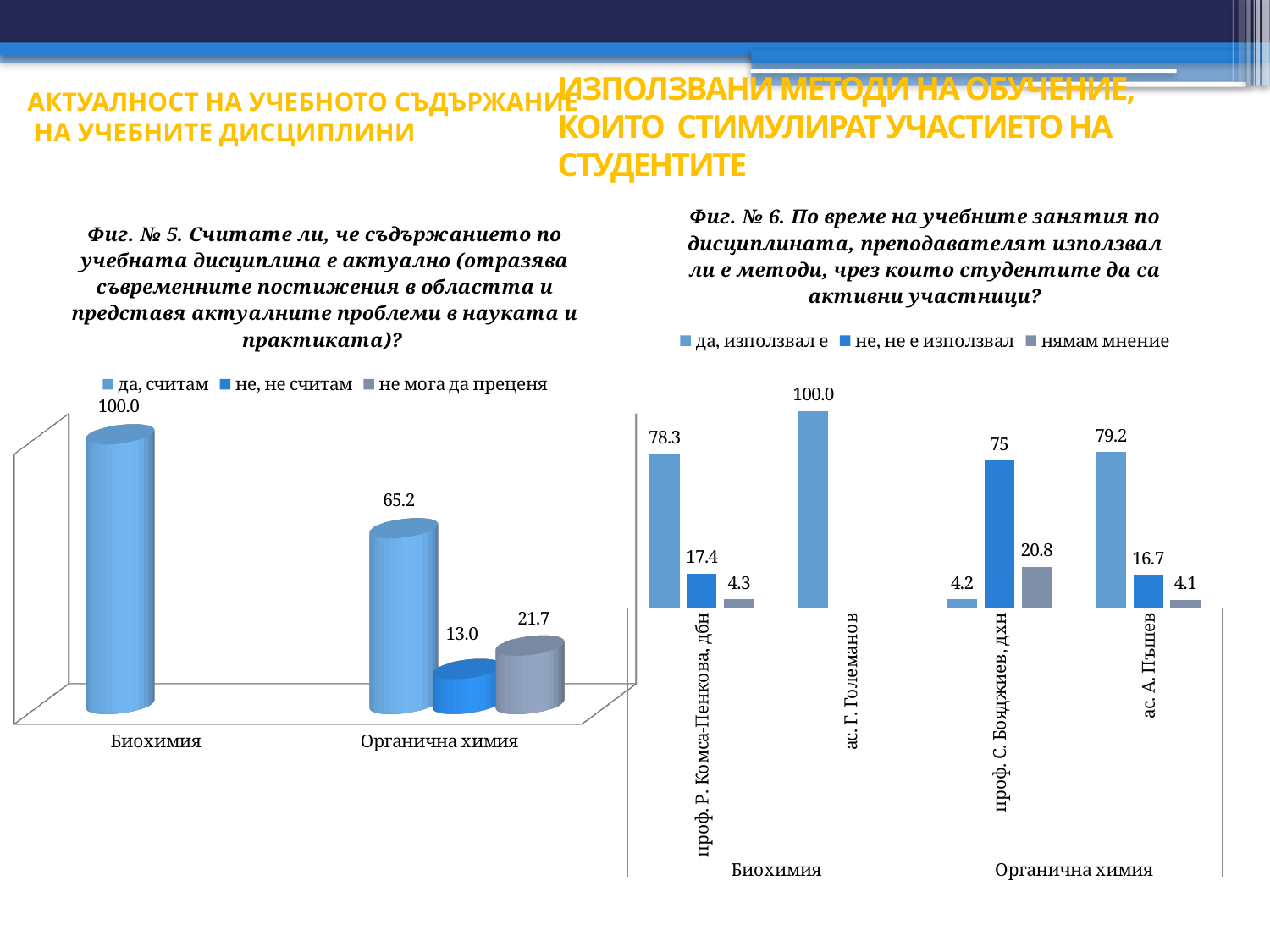
In the left chart (Фиг. № 5), what is the value of "не мога да преценя" for Органична химия? 21.7 In the left chart (Фиг. № 5), which is larger for Органична химия: "не, не считам" or "не мога да преценя"? не мога да преценя In the right chart (Фиг. № 6), which lecturer has the highest value for "да, използвал е"? ас. Г. Големанов What kind of chart is the right chart (Фиг. № 6)? bar chart In the left chart (Фиг. № 5), what is the value of "да, считам" for Органична химия? 65.2 In the left chart (Фиг. № 5), what is the value of "да, считам" for Биохимия? 100.0 In the right chart (Фиг. № 6), what is the value of "не, не е използвал" for проф. С. Бояджиев, дхн? 75 In the left chart (Фиг. № 5), how many series does the legend list? 3 In the left chart (Фиг. № 5), what is the difference between "да, считам" for Биохимия and for Органична химия? 34.8 In the right chart (Фиг. № 6), what is the value of "нямам мнение" for ас. А. Пъшев? 4.1 In the right chart (Фиг. № 6), what is the value of "да, използвал е" for проф. Р. Комса-Пенкова, дбн? 78.3 In the right chart (Фиг. № 6), what is the difference between "да, използвал е" for ас. А. Пъшев and "не, не е използвал" for ас. А. Пъшев? 62.5